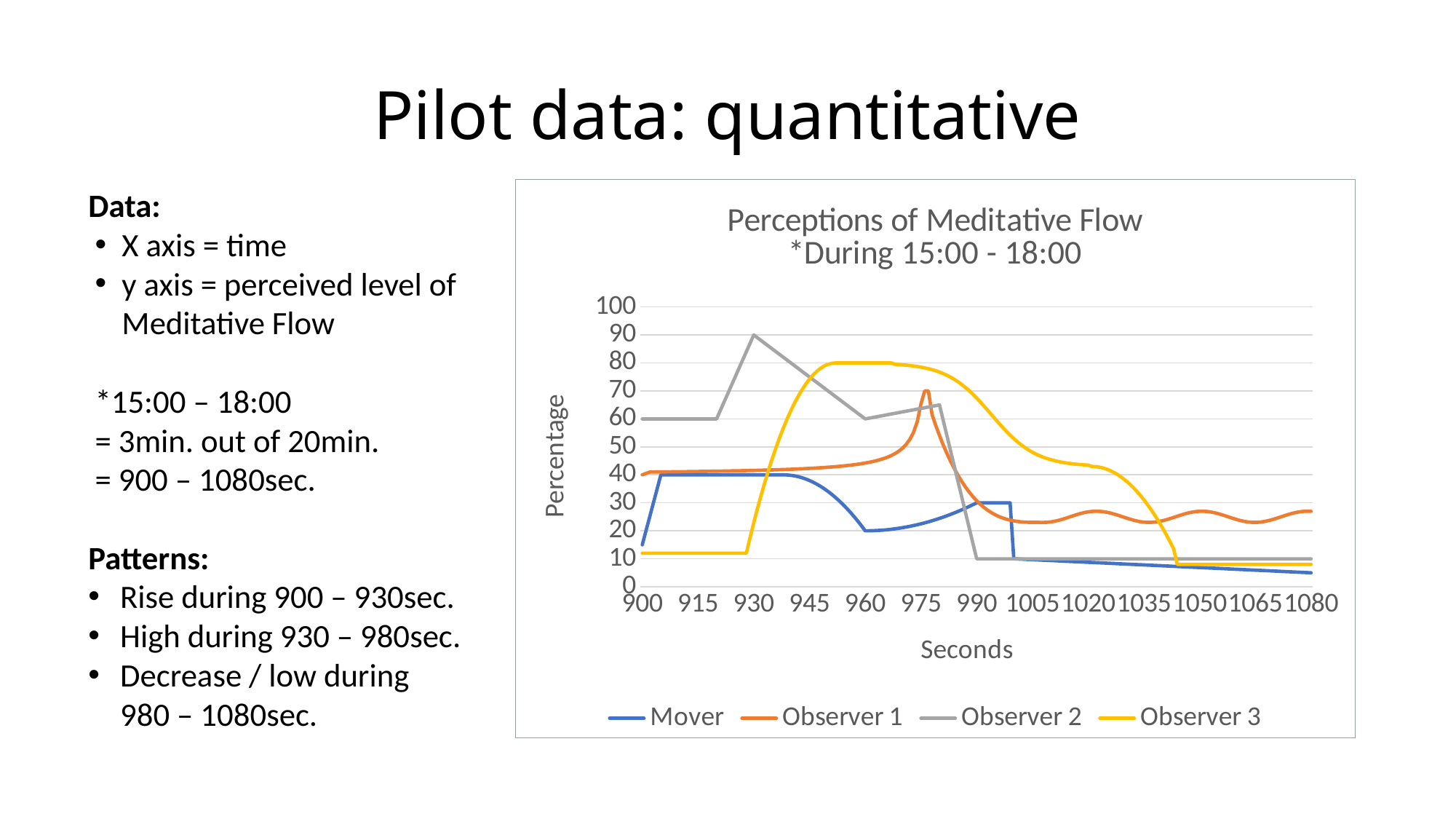
At 1080 seconds, which is higher, Observer 1 or Observer 3? Observer 1 What value does Observer 2 reach at 930 seconds? 90 What is the label on the chart's x axis? Seconds What kind of chart is shown on the slide? line chart Is the value for Observer 2 at 930 seconds greater or less than 80? greater At 900 seconds, which is higher, Observer 2 or Mover? Observer 2 How many series does the chart's legend list? 4 What is the title of the chart? Perceptions of Meditative Flow *During 15:00 - 18:00 Is the value for Observer 3 at 960 seconds greater or less than 70? greater Does the Observer 3 line rise or fall between 1035 and 1050 seconds? fall Which series reaches the highest value anywhere on the chart? Observer 2 Is the value for Mover at 1080 seconds greater or less than 10? less